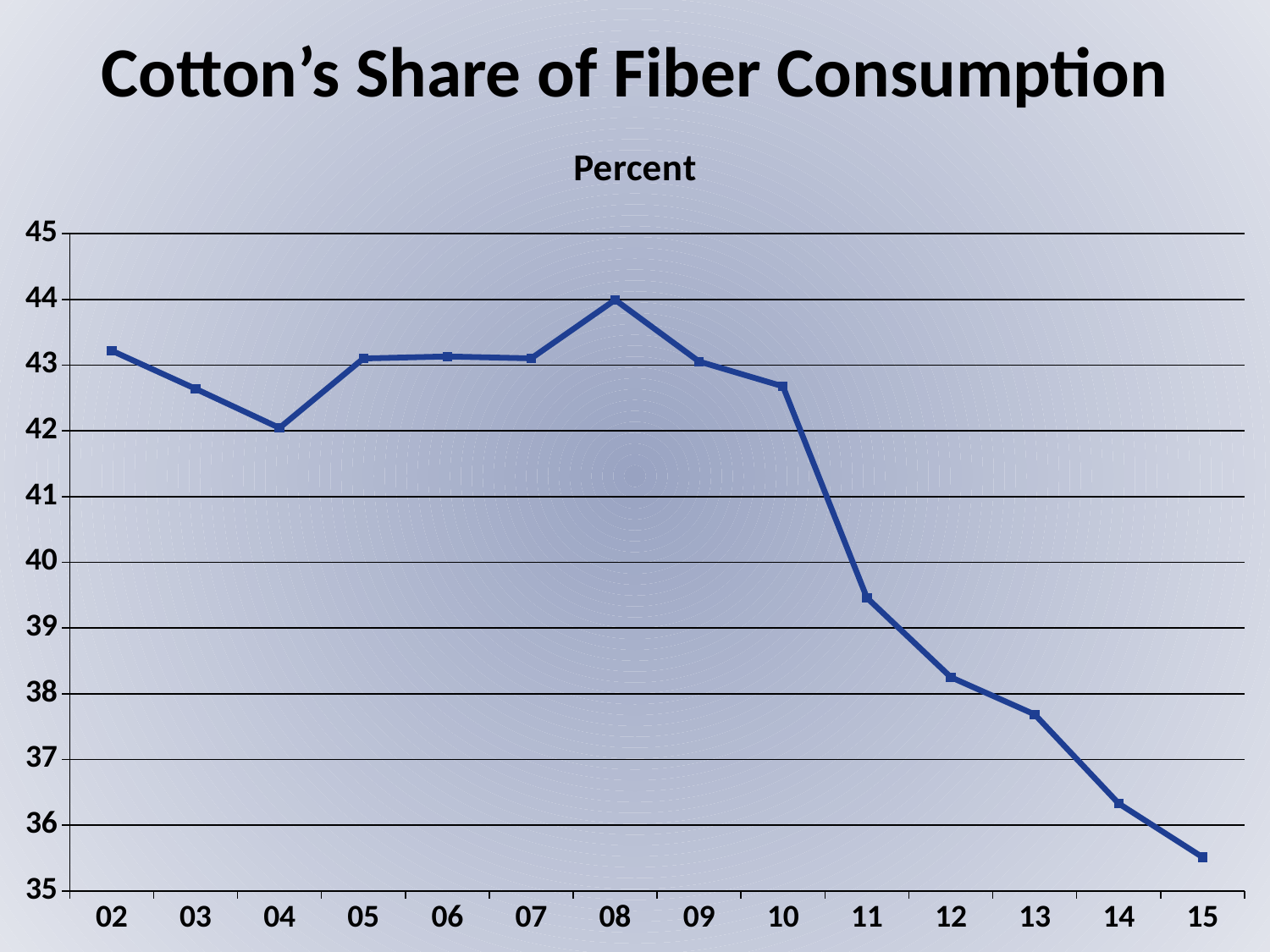
What kind of chart is shown on the slide? line chart Which year has the lowest cotton share of fiber consumption? 15 Is the value for 14 greater or less than 36? greater Which year has the highest cotton share of fiber consumption? 08 What is the title of the chart? Percent Is the value for 11 greater or less than 40? less Which is larger, the value for 02 or the value for 15? 02 Is the value for 10 greater or less than 43? less Do the values rise or fall from 10 to 15? fall How many data points are plotted on the line? 14